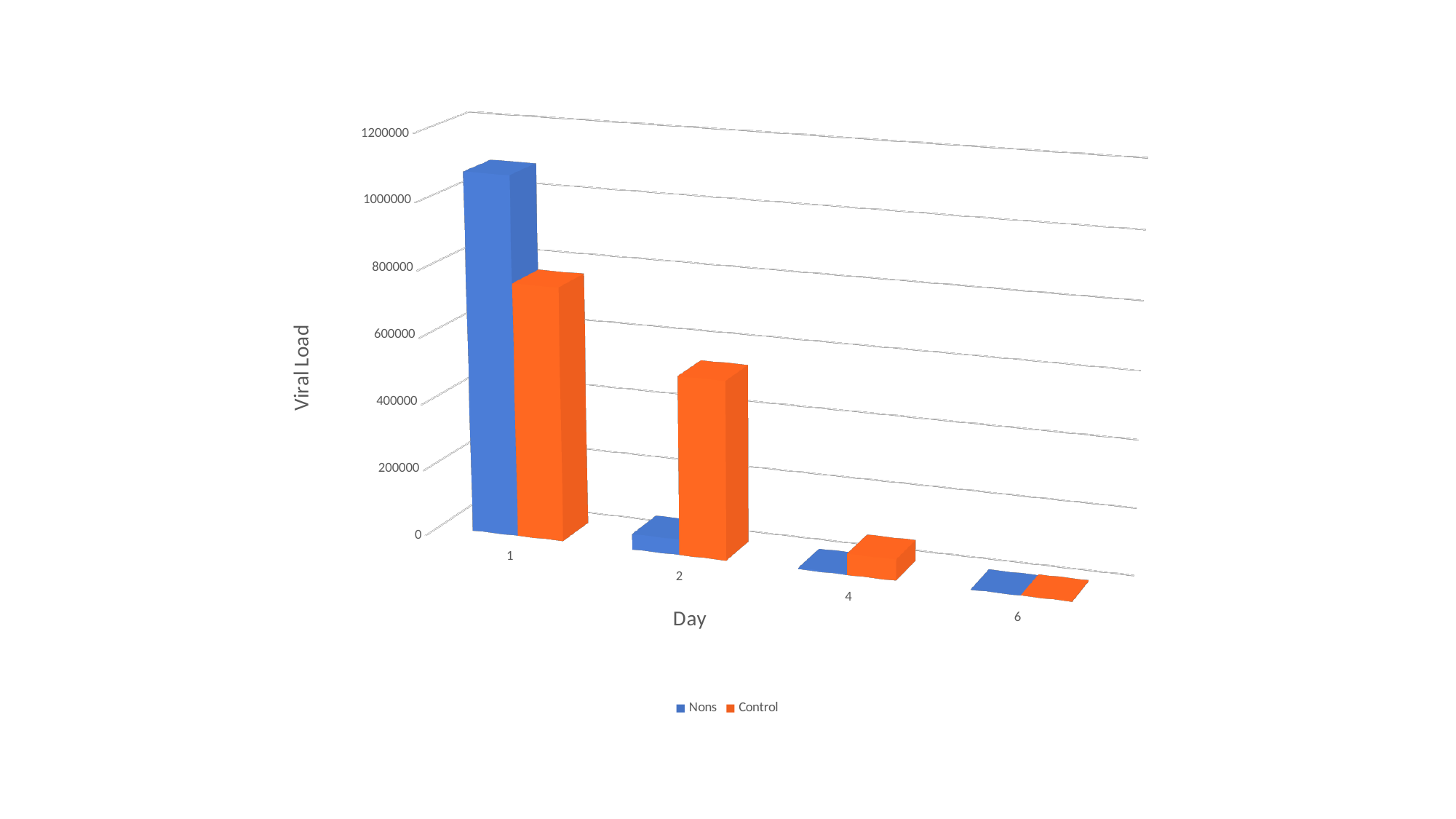
Is the Nons viral load on day 1 greater or less than 800000? greater Is the Control viral load on day 2 greater or less than 800000? less Is the Nons viral load on day 2 greater or less than 200000? less On day 1, which series has the larger viral load, Nons or Control? Nons On day 2, which series has the larger viral load, Nons or Control? Control What kind of chart is shown on the slide? bar chart On which day is the Nons viral load highest? 1 On which day is the Control viral load highest? 1 How many day categories are shown on the x axis? 4 What is the title of the vertical axis? Viral Load Does the Nons viral load rise or fall from day 1 to day 6? fall How many series does the legend list? 2